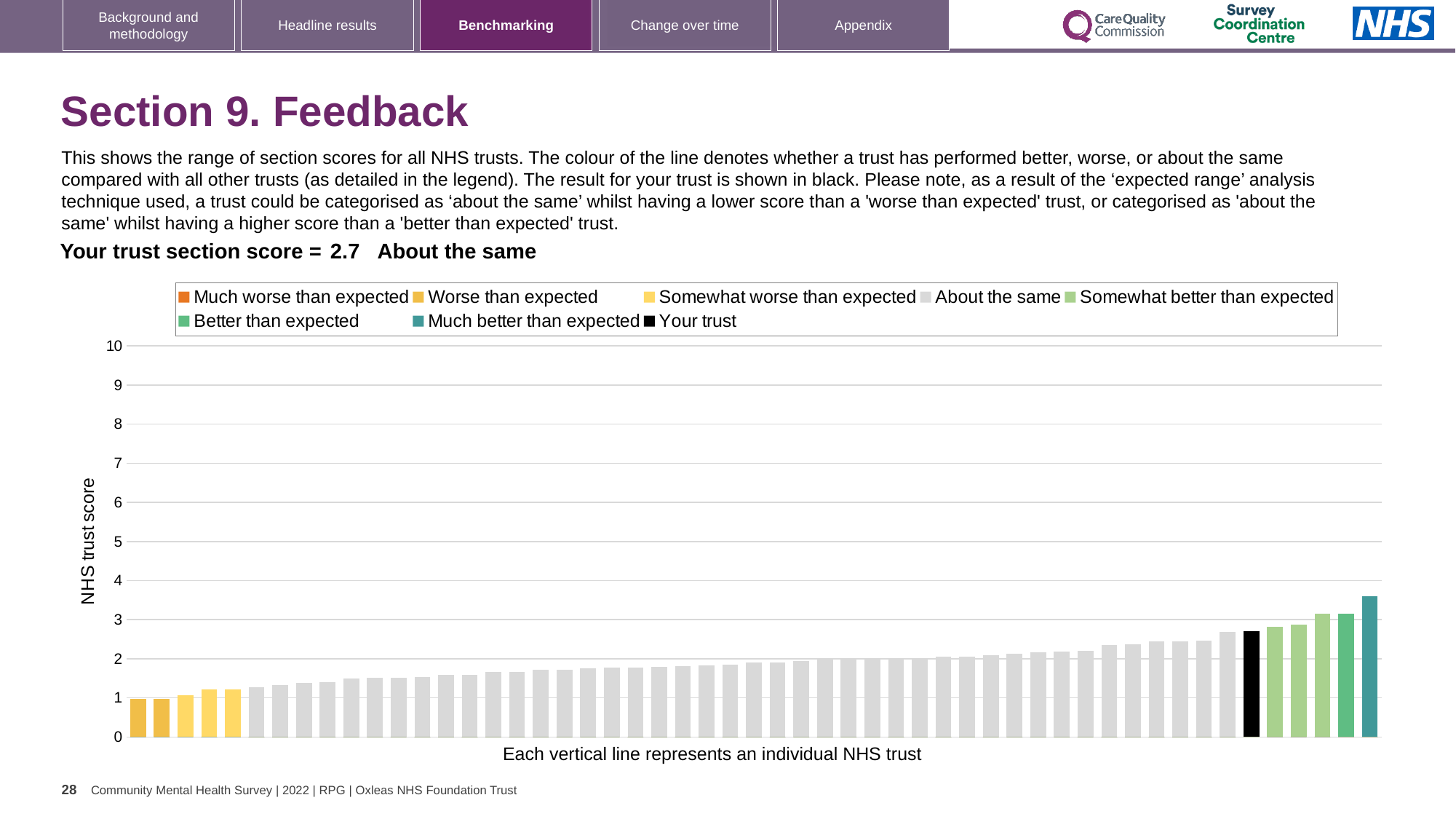
How many entries does the chart legend list? 8 Which legend category do the shortest bars on the left belong to? Worse than expected What colour is the bar representing your trust? black What kind of chart is shown on the slide? bar chart What is the section score for your trust shown on the slide? 2.7 Which legend category does the tallest bar belong to? Much better than expected Is the value of the shortest bar greater or less than 2? less Do the bar values rise or fall from left to right along the x axis? rise Which category is your trust's section score placed in? About the same Is the value of the tallest bar greater or less than 4? less Is the value of the tallest bar greater or less than 3? greater